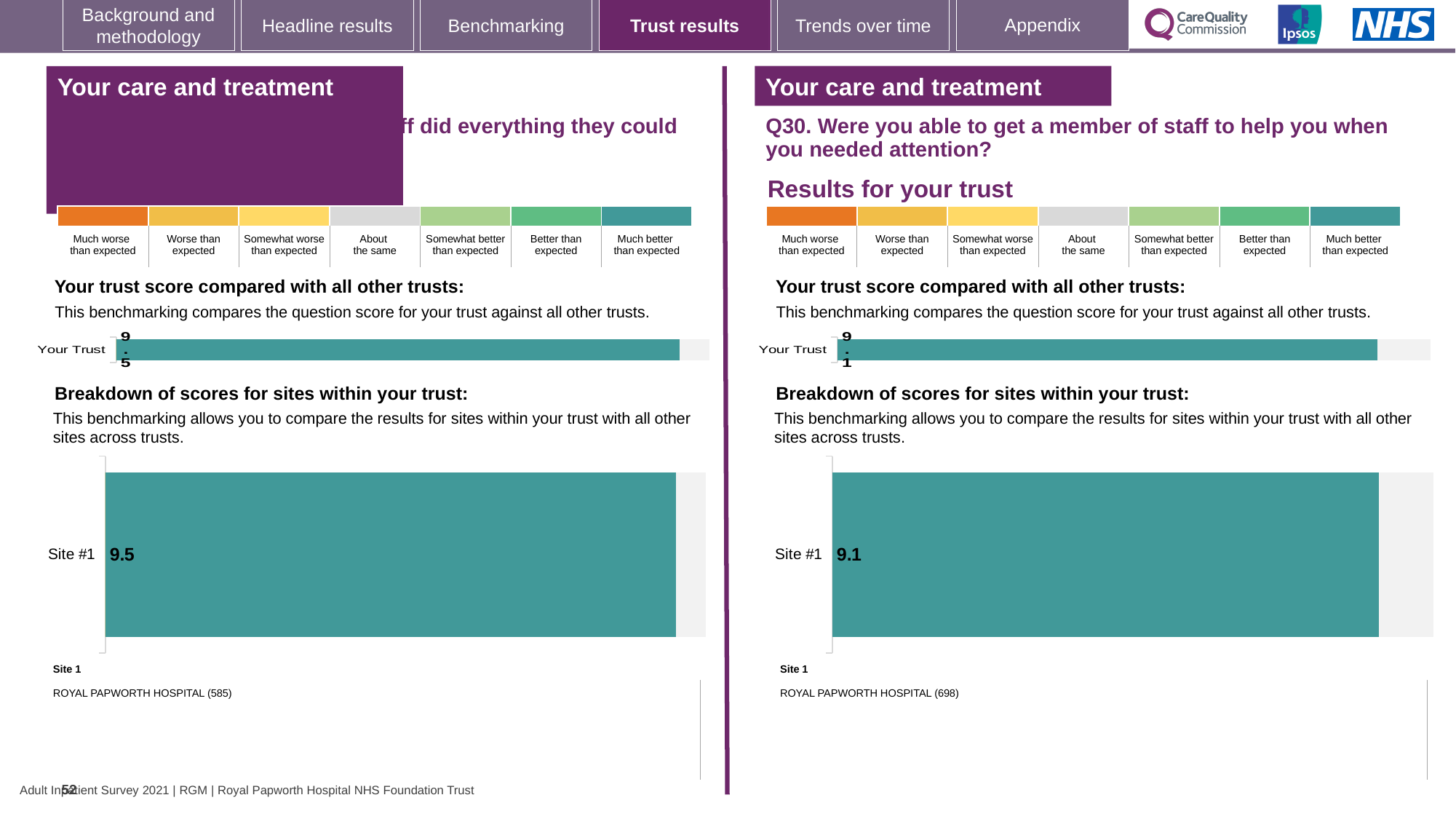
On the right-hand panel (Q30), what is the score shown for Your Trust in the 'Your trust score compared with all other trusts' chart? 9.1 On the right-hand panel (Q30), which colour band of the benchmark scale does the Your Trust bar match? Much better than expected What is the difference between the Site #1 score on the left-hand panel and the Site #1 score on the right-hand panel (Q30)? 0.4 On the left-hand panel, what is the score shown for Your Trust in the 'Your trust score compared with all other trusts' chart? 9.5 On the right-hand panel (Q30), what is the score for Site #1 in the 'Breakdown of scores for sites within your trust' chart? 9.1 How many categories are shown on the benchmark colour scale on the right-hand panel (Q30)? 7 Which is larger: the Your Trust score on the left-hand panel or the Your Trust score on the right-hand panel (Q30)? Left-hand panel How many sites are shown in the 'Breakdown of scores for sites within your trust' chart on the right-hand panel (Q30)? 1 What type of chart is used to show the Site #1 score on the left-hand panel? Bar chart Which site is listed as Site 1 on the right-hand panel (Q30)? ROYAL PAPWORTH HOSPITAL (698) On the left-hand panel, what is the score for Site #1 in the 'Breakdown of scores for sites within your trust' chart? 9.5